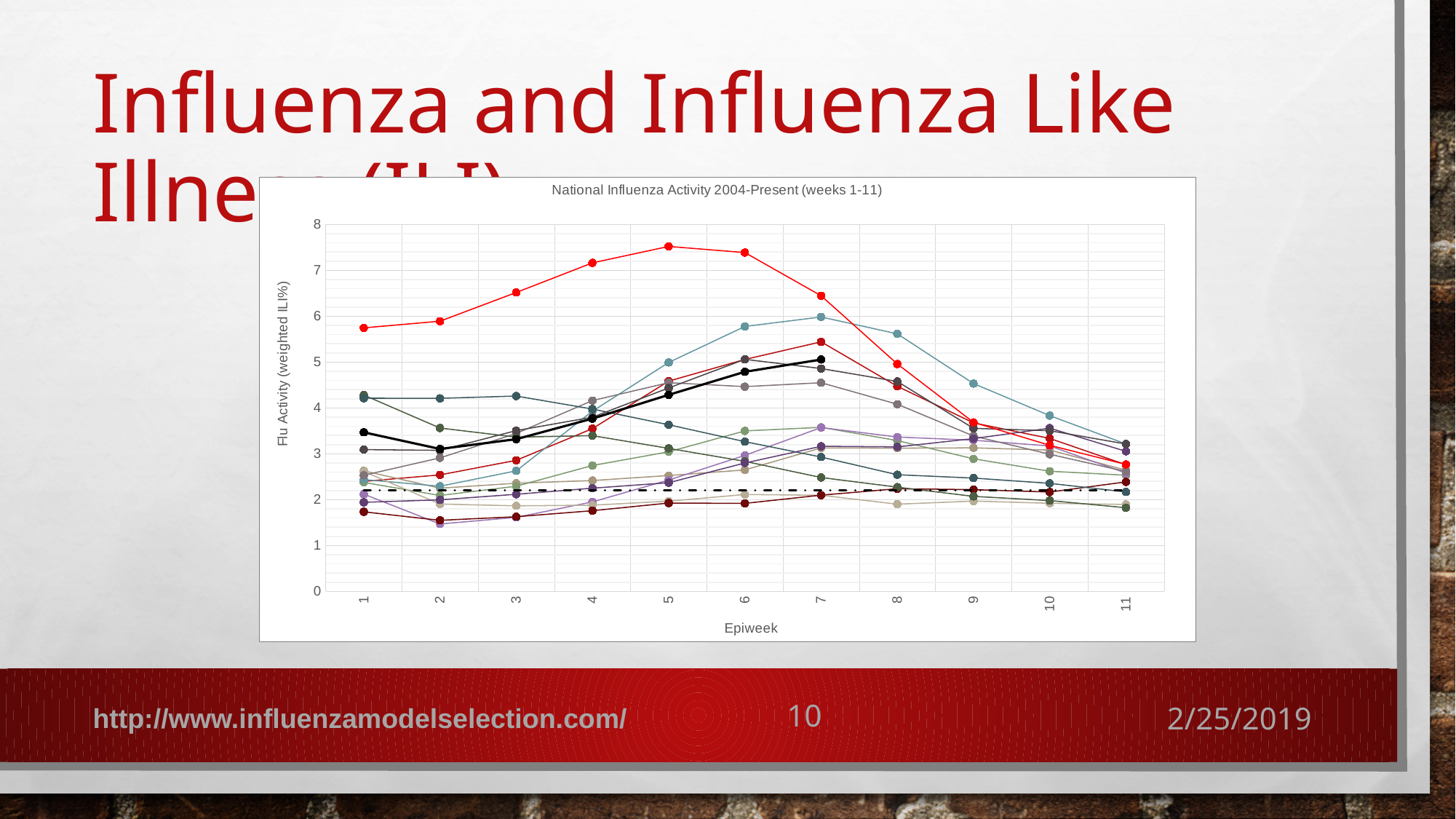
How many epiweeks are plotted along the x axis? 11 What kind of chart is shown on the slide? line chart Is the value of the red line at epiweek 11 greater or less than 3? less Is the value of the red line at epiweek 5 greater or less than 7? greater Is the value of the dashed black line at epiweek 6 greater or less than 3? less What is the title of the chart? National Influenza Activity 2004-Present (weeks 1-11) Does the red line rise or fall from epiweek 1 to epiweek 5? rise At which epiweek does the red line reach its highest value? 5 What is the label of the x axis? Epiweek Does the red line rise or fall from epiweek 7 to epiweek 11? fall What is the highest value shown on the y axis? 8